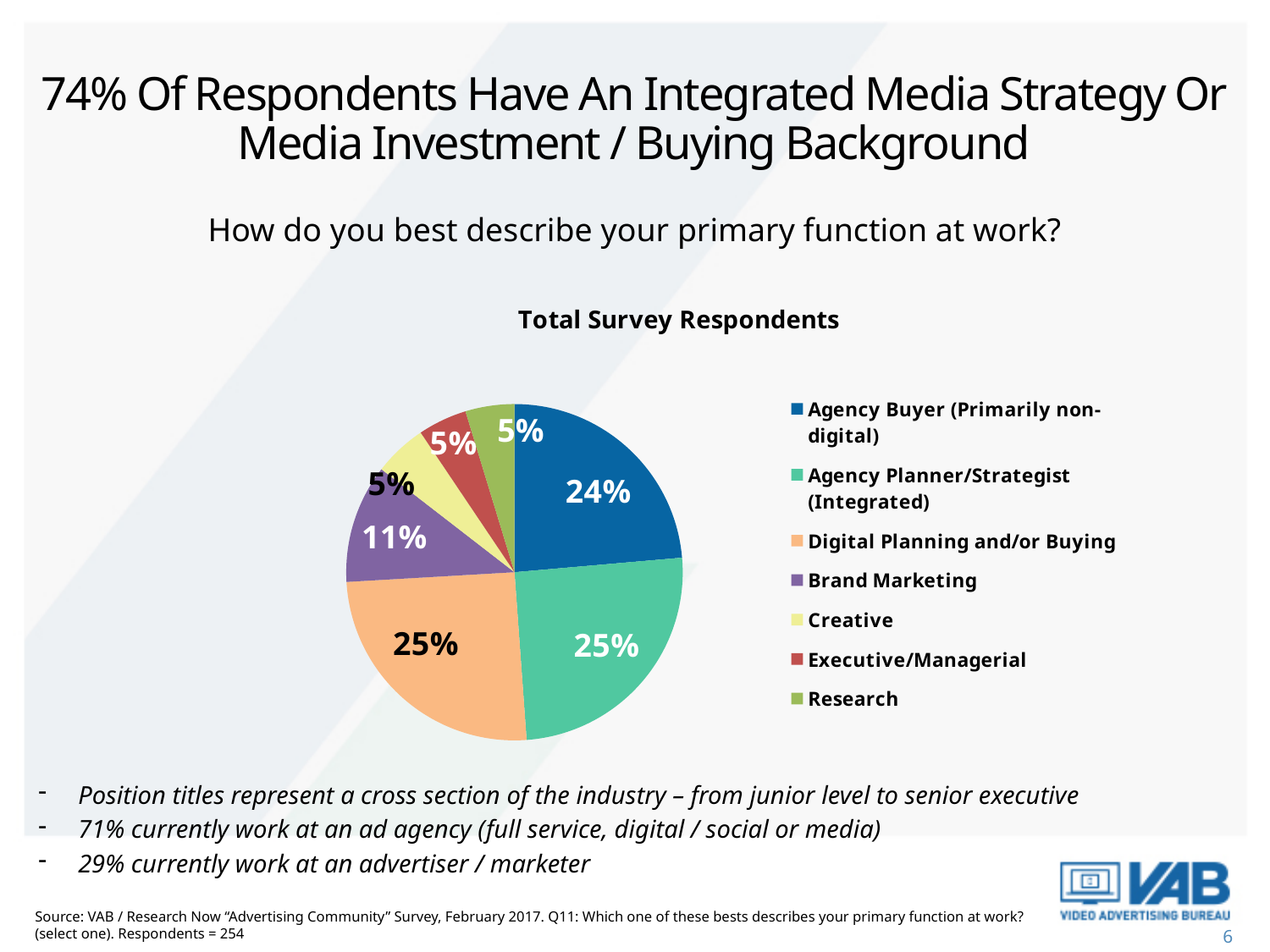
What share of respondents are in Digital Planning and/or Buying? 25% What is the difference in percentage points between the Agency Buyer (Primarily non-digital) share and the Executive/Managerial share? 19 percentage points What share of respondents are Agency Buyer (Primarily non-digital)? 24% What is the difference in percentage points between the Agency Planner/Strategist (Integrated) share and the Brand Marketing share? 14 percentage points What share of respondents are in Brand Marketing? 11% How many categories does the pie chart show? 7 What share of respondents are in Research? 5% What share of respondents are Agency Planner/Strategist (Integrated)? 25% What kind of chart is shown on the slide? Pie chart Which is larger, the share for Creative or the share for Digital Planning and/or Buying? Digital Planning and/or Buying Which is larger, the share for Agency Buyer (Primarily non-digital) or the share for Brand Marketing? Agency Buyer (Primarily non-digital) What is the title of the chart? Total Survey Respondents